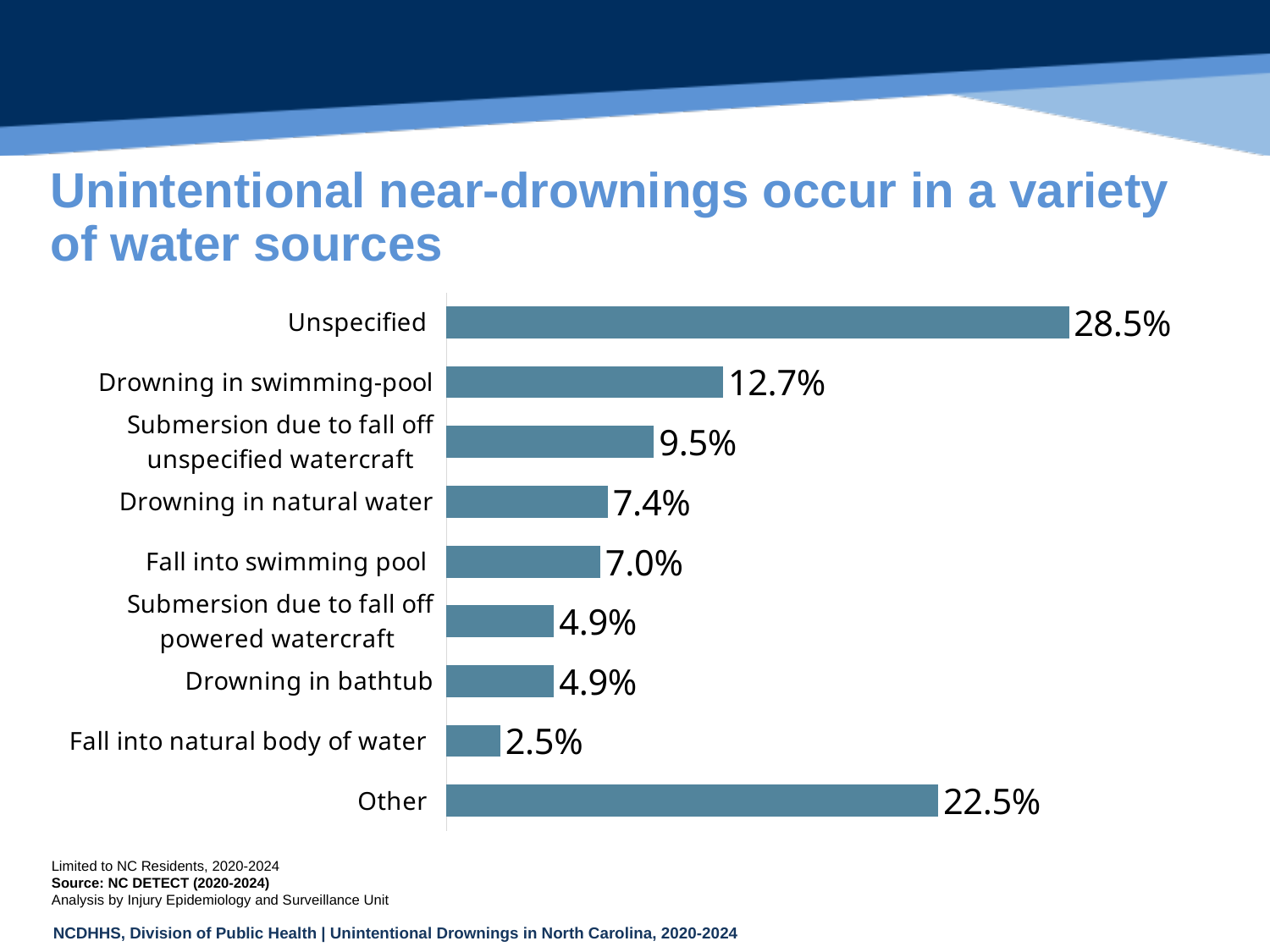
What is the value for Submersion due to fall off unspecified watercraft? 9.5% What is the difference in percentage points between Unspecified and Other? 6.0 What is the title of the slide? Unintentional near-drownings occur in a variety of water sources Which is larger: Drowning in swimming-pool or Drowning in natural water? Drowning in swimming-pool What percentage of unintentional near-drownings is attributed to drowning in swimming-pool? 12.7% What is the difference in percentage points between Drowning in natural water and Fall into swimming pool? 0.4 Which category has the highest percentage? Unspecified What type of chart is shown on the slide? Bar chart What is the value shown for Other? 22.5% What is the value shown for Fall into natural body of water? 2.5% How many categories are shown in the chart? 9 Which category has the lowest percentage? Fall into natural body of water